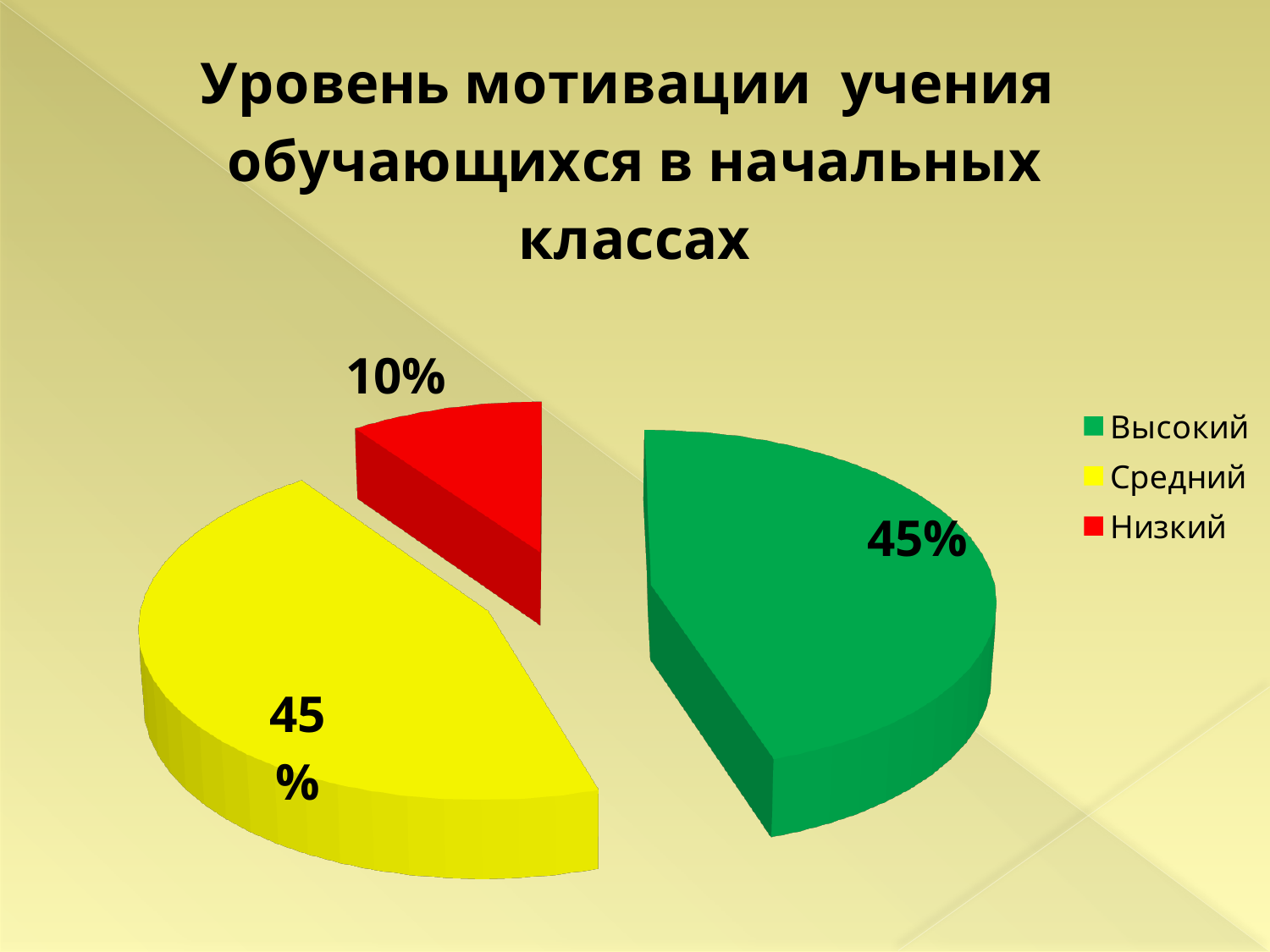
What is the title of the chart on the slide? Уровень мотивации учения обучающихся в начальных классах Which category has the smallest slice of the pie? Низкий What is the difference between the Высокий value and the Низкий value? 35% What percentage is shown for the Высокий slice? 45% How many entries does the legend list? 3 What percentage is shown for the Средний slice? 45% What kind of chart is shown on the slide? Pie chart Which is larger, the Высокий slice or the Низкий slice? Высокий What percentage is shown for the Низкий slice? 10% What share of the pie does the Низкий slice represent? 10% How many slices does the pie chart have? 3 What colour is the Низкий slice? Red